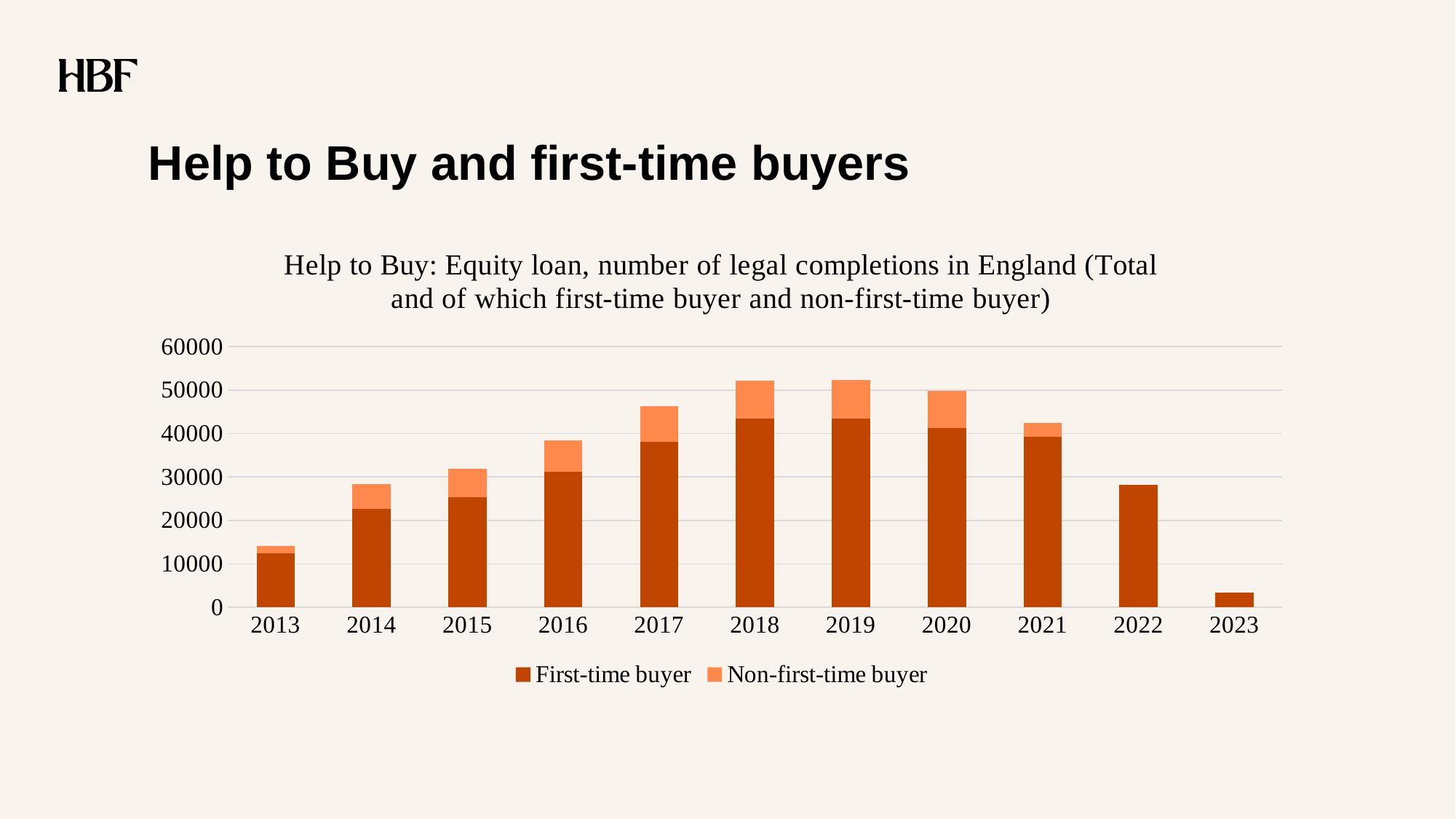
Do the total completions rise or fall from 2019 to 2023? fall Which year has the larger total number of completions, 2016 or 2017? 2017 Which series is shown in the lighter orange colour in the chart? Non-first-time buyer How many years are shown on the x axis of the chart? 11 Is the total value for 2018 greater or less than 50000? greater How many series does the chart's legend list? 2 Which year has the larger total number of completions, 2021 or 2022? 2021 Is the First-time buyer value for 2022 greater or less than 30000? less Which year has the lowest total number of legal completions? 2023 What kind of chart is shown on the slide? Stacked bar chart Is the total value for 2023 greater or less than 10000? less